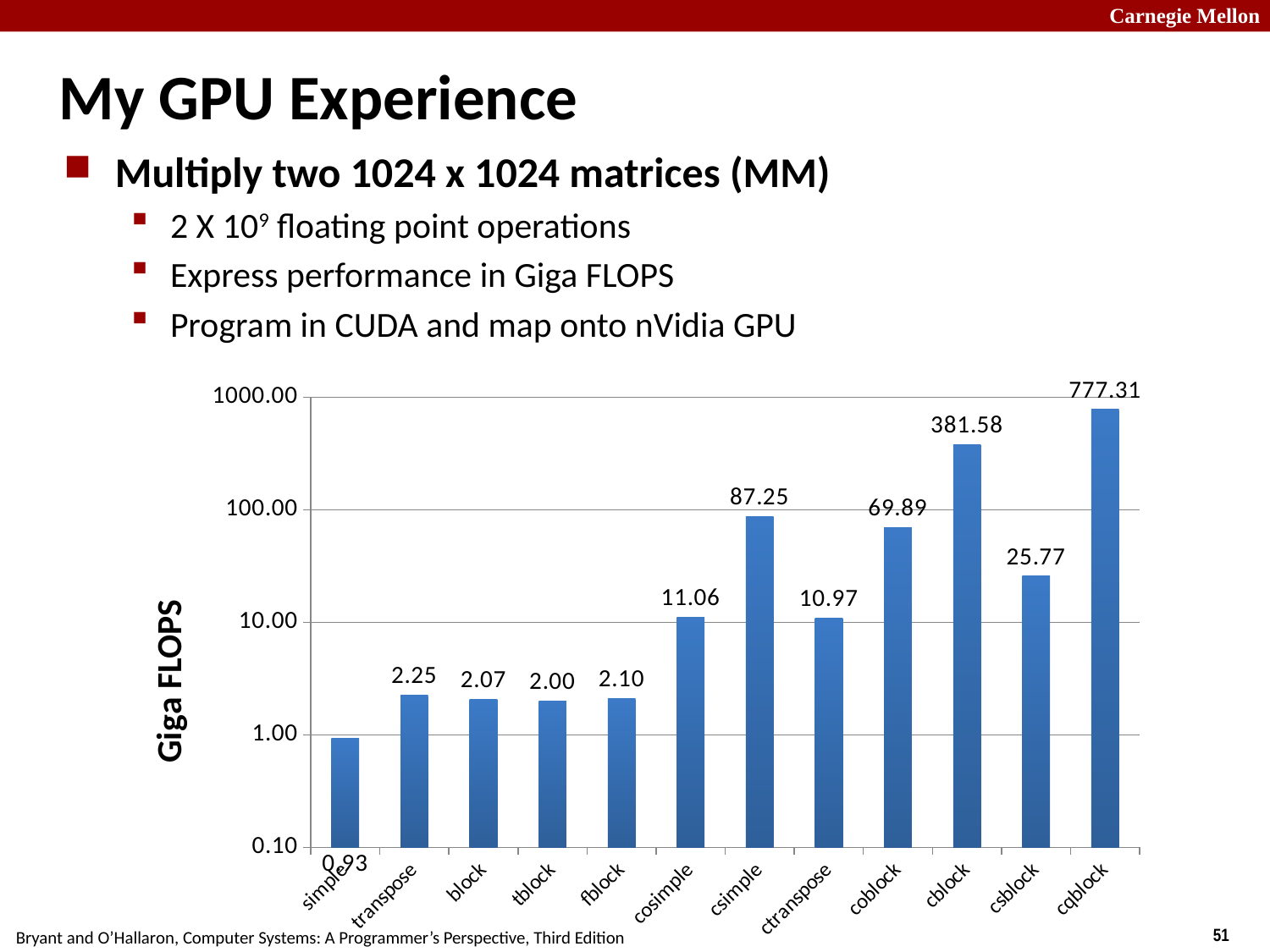
What is the difference in Giga FLOPS between cqblock and cblock? 395.73 Which has a higher Giga FLOPS value, cblock or coblock? cblock What is the Giga FLOPS value for csblock? 25.77 What is the Giga FLOPS value for cqblock? 777.31 What is the Giga FLOPS value for csimple? 87.25 What is the Giga FLOPS value for transpose? 2.25 Which category has the highest Giga FLOPS value? cqblock How many categories are shown on the x axis of the chart? 12 What is the difference in Giga FLOPS between csimple and coblock? 17.36 Which category has the lowest Giga FLOPS value? simple What kind of chart is shown on the slide? bar chart Is the value for cosimple greater or less than 10.00? greater